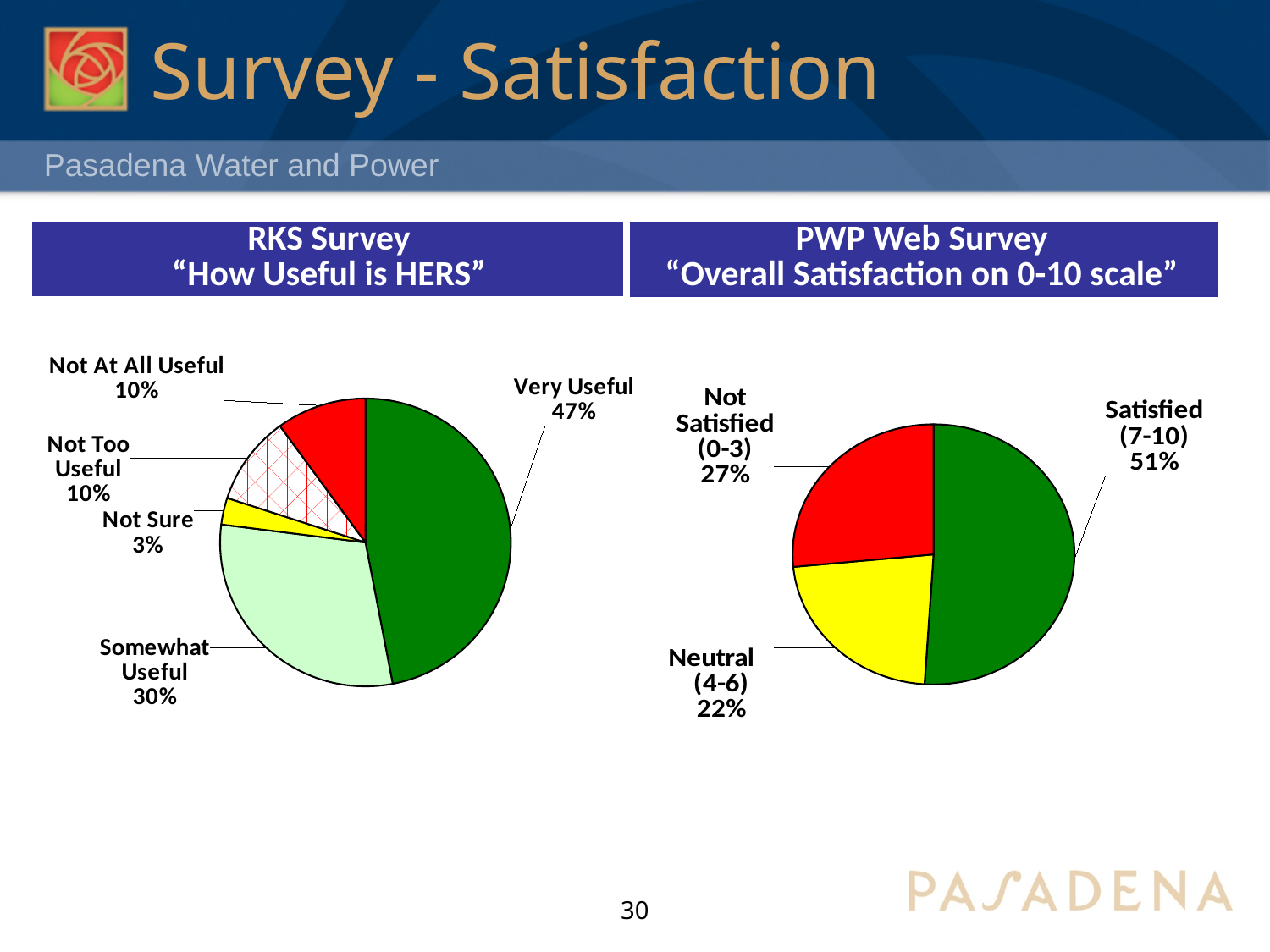
In the PWP Web Survey "Overall Satisfaction on 0-10 scale" pie chart, what is the difference between the Satisfied (7-10) and Not Satisfied (0-3) shares? 24% In the RKS Survey "How Useful is HERS" pie chart, what is the difference between the Very Useful and Somewhat Useful shares? 17% What type of chart is used for the PWP Web Survey "Overall Satisfaction on 0-10 scale"? Pie chart In the RKS Survey "How Useful is HERS" pie chart, what share is labelled Very Useful? 47% In the PWP Web Survey "Overall Satisfaction on 0-10 scale" pie chart, what share is labelled Neutral (4-6)? 22% In the RKS Survey "How Useful is HERS" pie chart, which category has the smallest share? Not Sure In the PWP Web Survey "Overall Satisfaction on 0-10 scale" pie chart, which is larger: Not Satisfied (0-3) or Neutral (4-6)? Not Satisfied (0-3) In the PWP Web Survey "Overall Satisfaction on 0-10 scale" pie chart, what colour is the Neutral (4-6) slice? Yellow In the RKS Survey "How Useful is HERS" pie chart, which category has the largest share? Very Useful In the PWP Web Survey "Overall Satisfaction on 0-10 scale" pie chart, what share is labelled Satisfied (7-10)? 51% How many slices does the RKS Survey "How Useful is HERS" pie chart have? 5